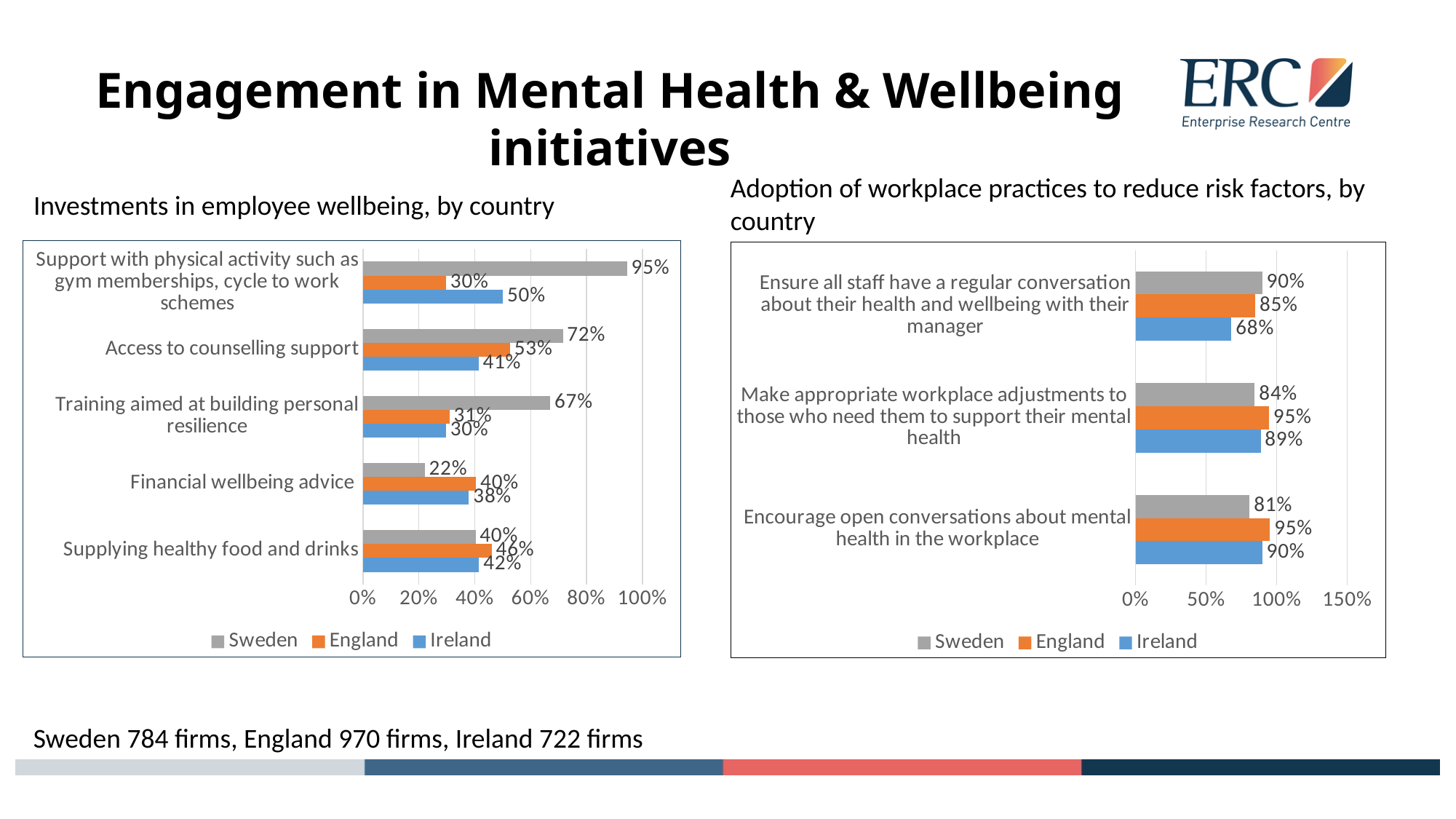
In the 'Adoption of workplace practices to reduce risk factors, by country' chart, what is the difference between England and Sweden for 'Encourage open conversations about mental health in the workplace'? 14 percentage points In the 'Investments in employee wellbeing, by country' chart, what is the value for Sweden for 'Support with physical activity such as gym memberships, cycle to work schemes'? 95% In the 'Adoption of workplace practices to reduce risk factors, by country' chart, is the value for Sweden or Ireland larger for 'Make appropriate workplace adjustments to those who need them to support their mental health'? Ireland In the 'Adoption of workplace practices to reduce risk factors, by country' chart, what is the value for England for 'Encourage open conversations about mental health in the workplace'? 95% What kind of chart is the 'Investments in employee wellbeing, by country' chart? Bar chart In the 'Investments in employee wellbeing, by country' chart, which country has the lowest value for 'Training aimed at building personal resilience'? Ireland How many series does the legend of the 'Adoption of workplace practices to reduce risk factors, by country' chart list? 3 In the 'Investments in employee wellbeing, by country' chart, what is the difference between Sweden and England for 'Access to counselling support'? 19 percentage points In the 'Investments in employee wellbeing, by country' chart, how many categories are shown? 5 In the 'Investments in employee wellbeing, by country' chart, what is the value for Ireland for 'Access to counselling support'? 41% In the 'Investments in employee wellbeing, by country' chart, which country has the highest value for 'Financial wellbeing advice'? England In the 'Adoption of workplace practices to reduce risk factors, by country' chart, what is the value for Ireland for 'Ensure all staff have a regular conversation about their health and wellbeing with their manager'? 68%